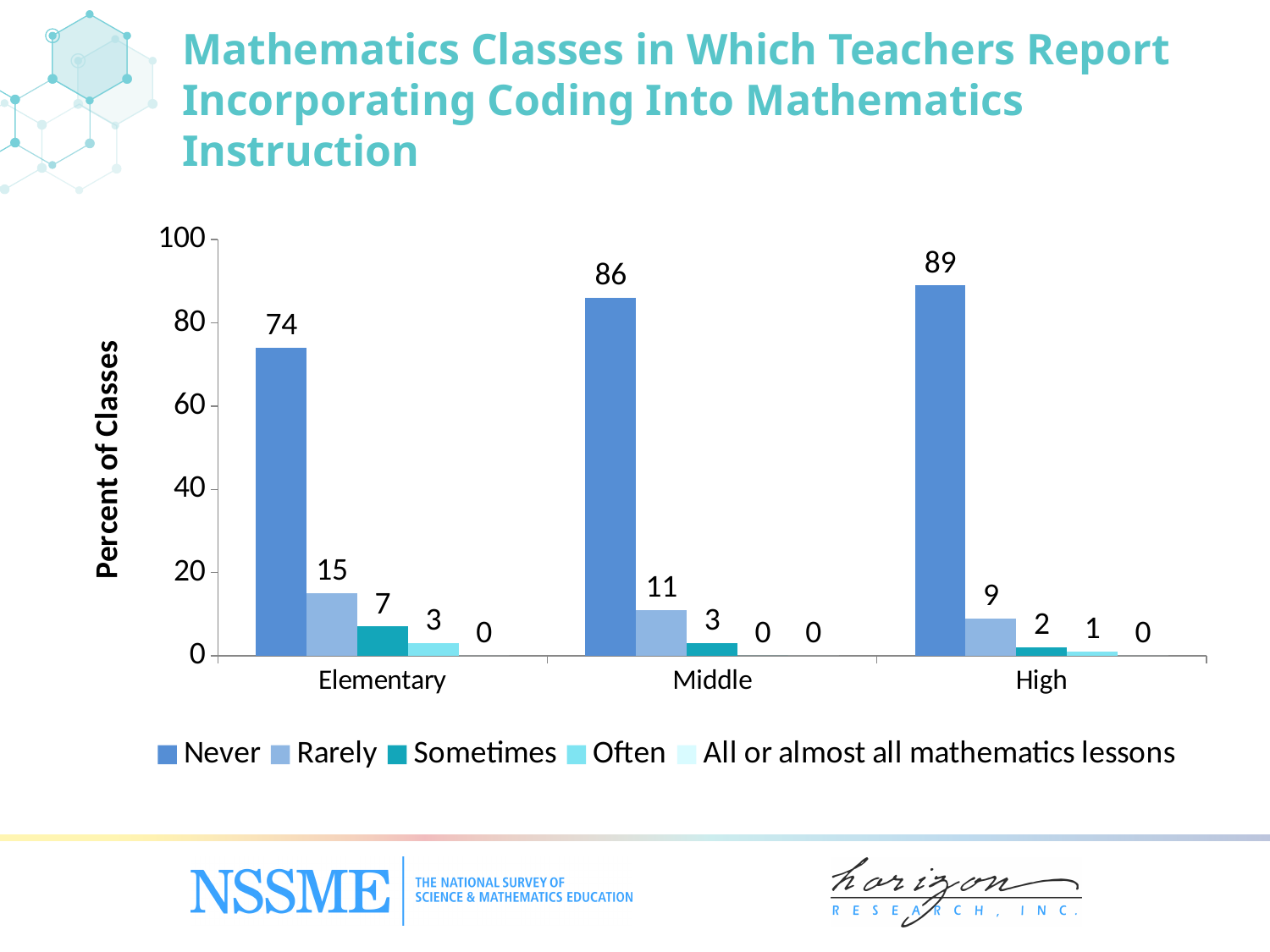
How many grade-level categories are shown on the x axis? 3 What is the difference between the 'Never' values for High and Elementary classes? 15 What is the value for 'Rarely' in Middle school classes? 11 How many series does the legend list? 5 Which grade level has the lowest value for 'Rarely'? High What is the label of the y axis? Percent of Classes What percent of Elementary mathematics classes report 'Never' incorporating coding? 74 Which grade level has the highest value for 'Never'? High What is the value for 'Sometimes' in High school classes? 2 Is the 'Never' value for Middle school classes greater or less than 80? greater What kind of chart is shown on the slide? Bar chart Which is larger: the 'Sometimes' value for Elementary or for Middle? Elementary